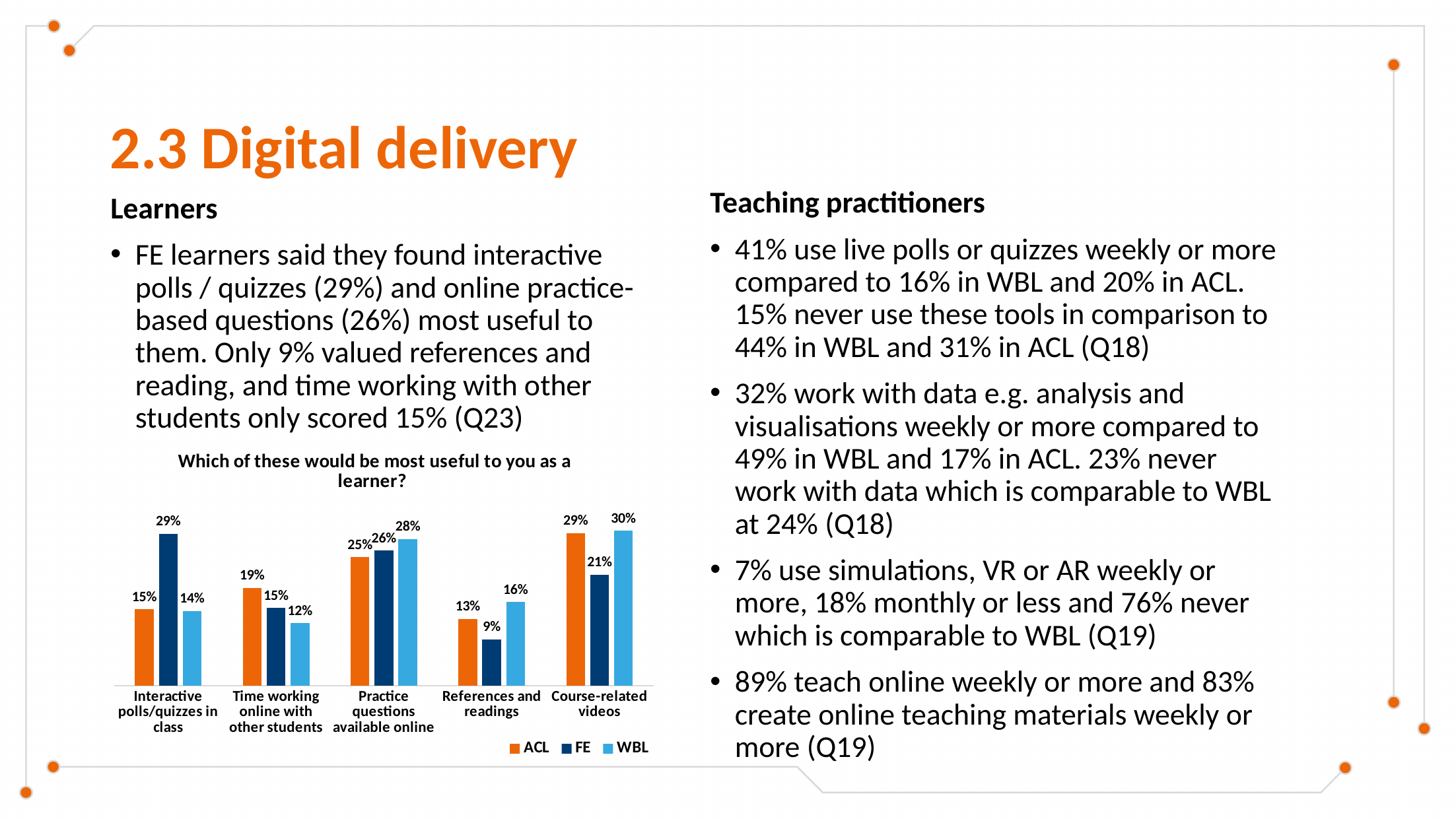
What is the WBL value for Course-related videos? 30% How many series does the chart's legend list? 3 Which category has the highest WBL value? Course-related videos How many categories are shown on the x axis of the chart? 5 What is the ACL value for Time working online with other students? 19% Which category has the lowest FE value? References and readings Which series is shown in orange in the chart's legend? ACL Which is larger for Practice questions available online: the ACL value or the WBL value? WBL What is the difference between the WBL and FE values for References and readings? 7% What kind of chart is shown on the slide? Bar chart What is the title of the chart? Which of these would be most useful to you as a learner? What is the FE value for Interactive polls/quizzes in class? 29%